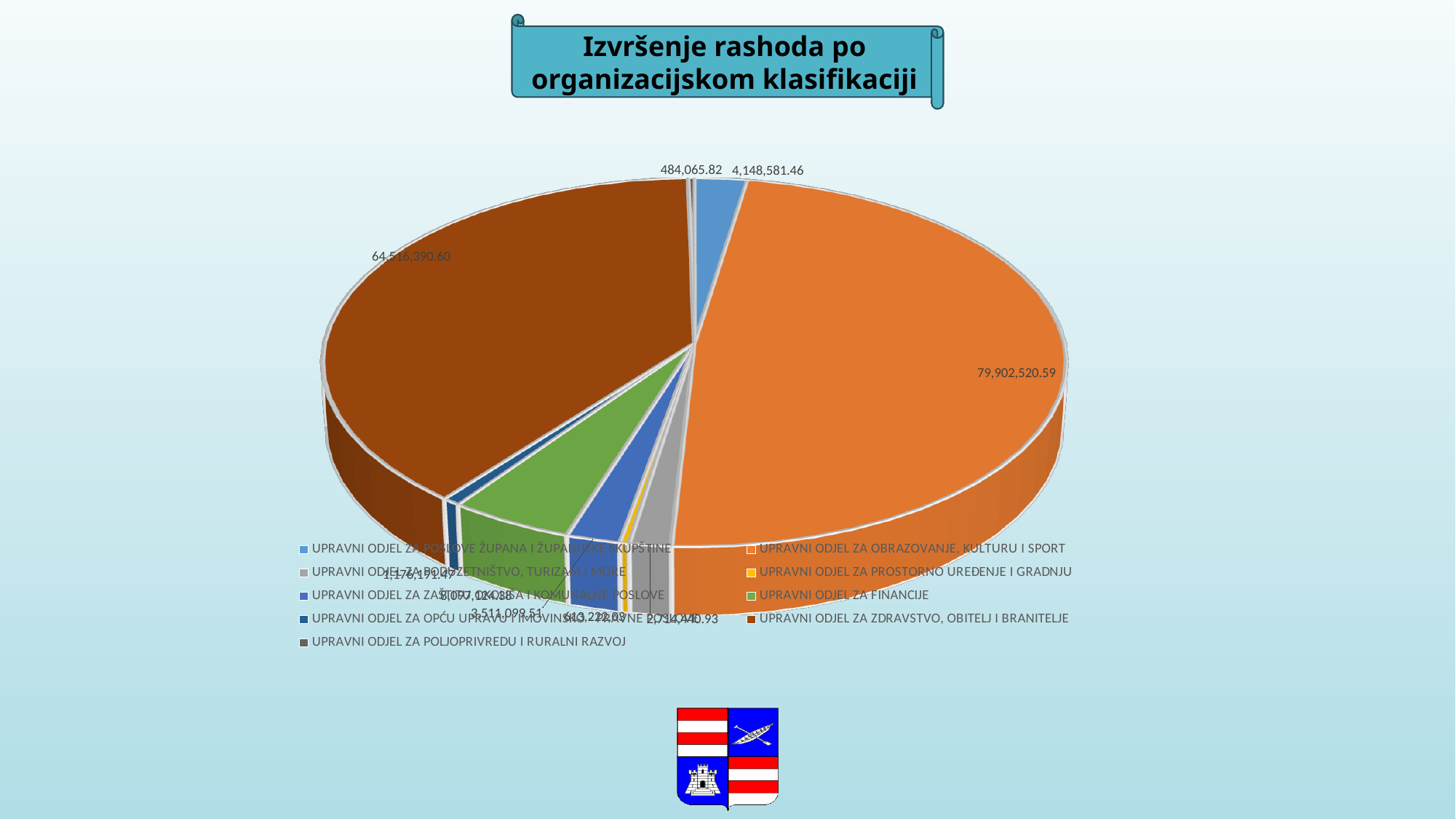
What is the value for UPRAVNI ODJEL ZA OBRAZOVANJE, KULTURU I SPORT? 79,902,520.59 What is the title of the chart? Izvršenje rashoda po organizacijskom klasifikaciji What is the value for UPRAVNI ODJEL ZA ZDRAVSTVO, OBITELJ I BRANITELJE? 64,516,390.60 What is the value for UPRAVNI ODJEL ZA POLJOPRIVREDU I RURALNI RAZVOJ? 484,065.82 What colour is the largest slice of the pie? Orange Which category has the largest slice of the pie? UPRAVNI ODJEL ZA OBRAZOVANJE, KULTURU I SPORT How many categories does the legend list? 9 What is the difference between the values for UPRAVNI ODJEL ZA OBRAZOVANJE, KULTURU I SPORT and UPRAVNI ODJEL ZA ZDRAVSTVO, OBITELJ I BRANITELJE? 15,386,129.99 What kind of chart is shown on the slide? Pie chart What is the difference between the values for UPRAVNI ODJEL ZA OBRAZOVANJE, KULTURU I SPORT and UPRAVNI ODJEL ZA POSLOVE ŽUPANA I ŽUPANIJSKE SKUPŠTINE? 75,753,939.13 What is the value for UPRAVNI ODJEL ZA POSLOVE ŽUPANA I ŽUPANIJSKE SKUPŠTINE? 4,148,581.46 Which is larger: the value for UPRAVNI ODJEL ZA OBRAZOVANJE, KULTURU I SPORT or for UPRAVNI ODJEL ZA ZDRAVSTVO, OBITELJ I BRANITELJE? UPRAVNI ODJEL ZA OBRAZOVANJE, KULTURU I SPORT